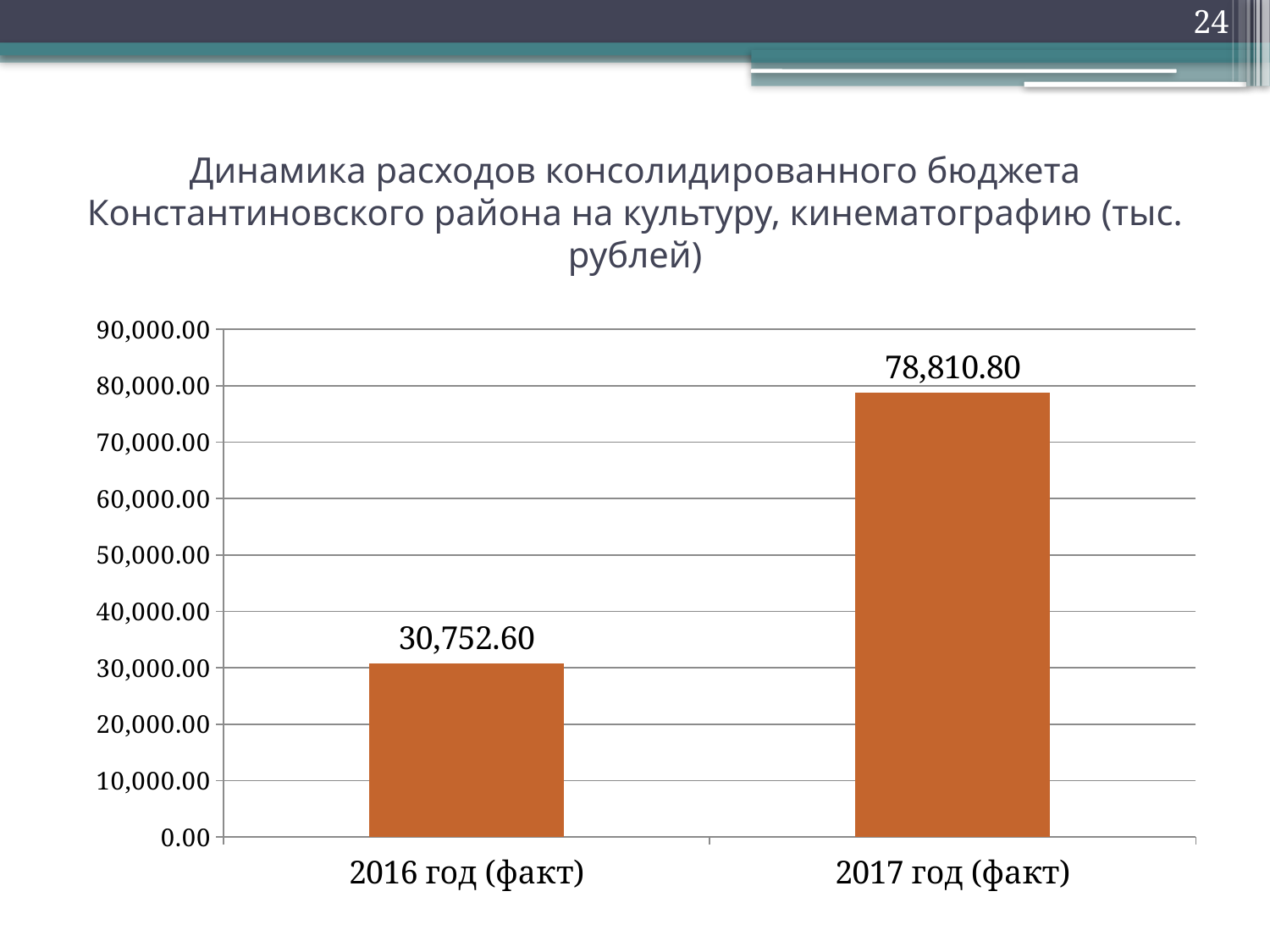
What kind of chart is shown on the slide? bar chart What is the value for 2017 год (факт)? 78,810.80 Is the value for 2017 год (факт) greater or less than 70,000.00? greater Is the value for 2016 год (факт) greater or less than 40,000.00? less What is the highest value shown on the vertical axis? 90,000.00 Do the values rise or fall from 2016 год (факт) to 2017 год (факт)? rise What is the difference between the values for 2017 год (факт) and 2016 год (факт)? 48,058.20 What is the value for 2016 год (факт)? 30,752.60 Which category has the lowest value? 2016 год (факт) Which category has the highest value? 2017 год (факт) Which is larger, the value for 2016 год (факт) or the value for 2017 год (факт)? 2017 год (факт) How many categories are shown on the x axis? 2